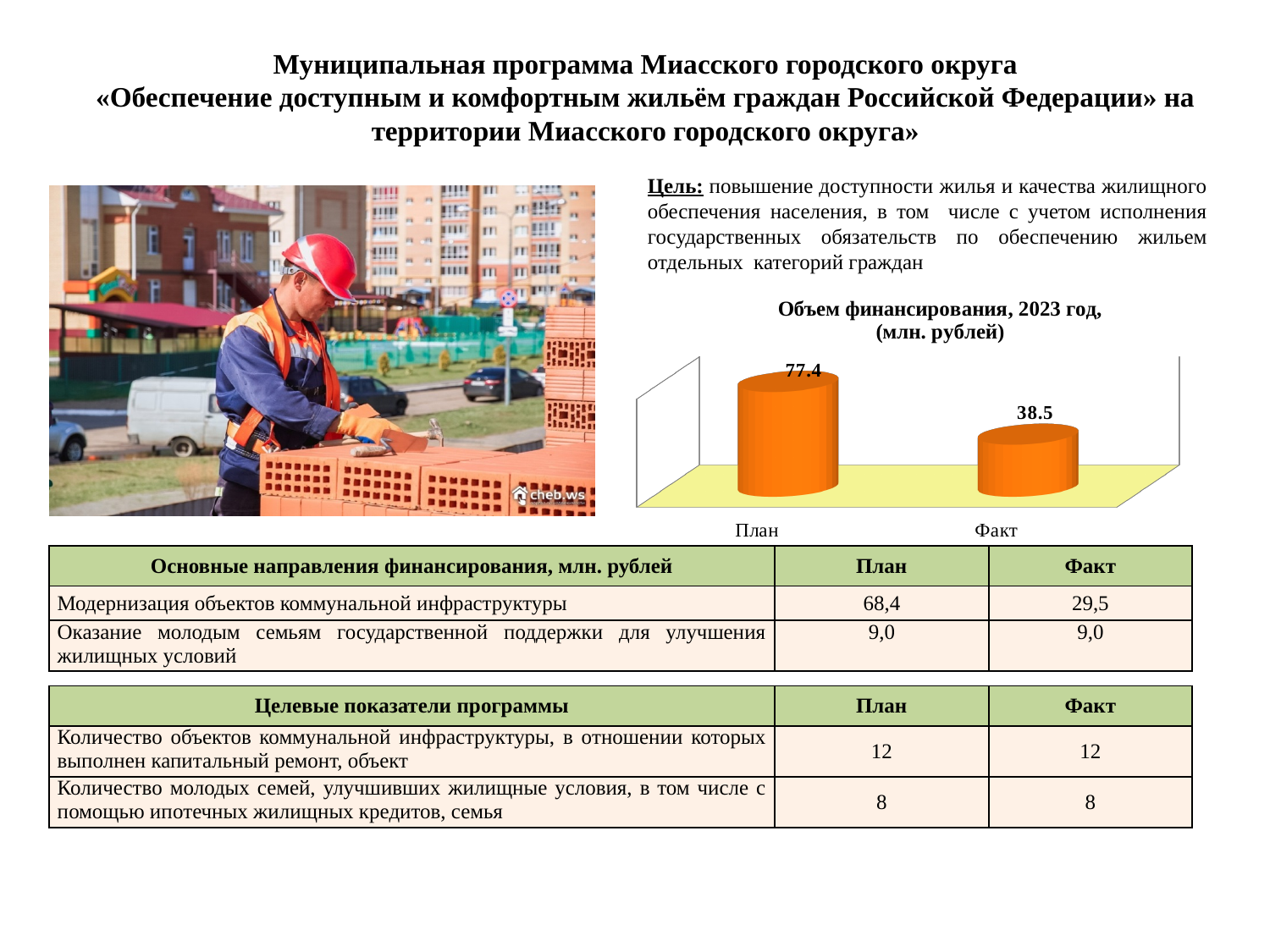
What is the value for План in the chart 'Объем финансирования, 2023 год, (млн. рублей)'? 77.4 How many categories are plotted in the chart 'Объем финансирования, 2023 год, (млн. рублей)'? 2 Which category has the highest value in the chart 'Объем финансирования, 2023 год, (млн. рублей)'? План Do the values fall or rise from План to Факт in the chart 'Объем финансирования, 2023 год, (млн. рублей)'? Fall Which category has the lowest value in the chart 'Объем финансирования, 2023 год, (млн. рублей)'? Факт What kind of chart is 'Объем финансирования, 2023 год, (млн. рублей)'? Bar chart What is the title of the chart on the slide? Объем финансирования, 2023 год, (млн. рублей) What is the value for Факт in the chart 'Объем финансирования, 2023 год, (млн. рублей)'? 38.5 What is the difference between the План and Факт values in the chart 'Объем финансирования, 2023 год, (млн. рублей)'? 38.9 What colour are the bars in the chart 'Объем финансирования, 2023 год, (млн. рублей)'? Orange In the chart 'Объем финансирования, 2023 год, (млн. рублей)', which is larger: План or Факт? План